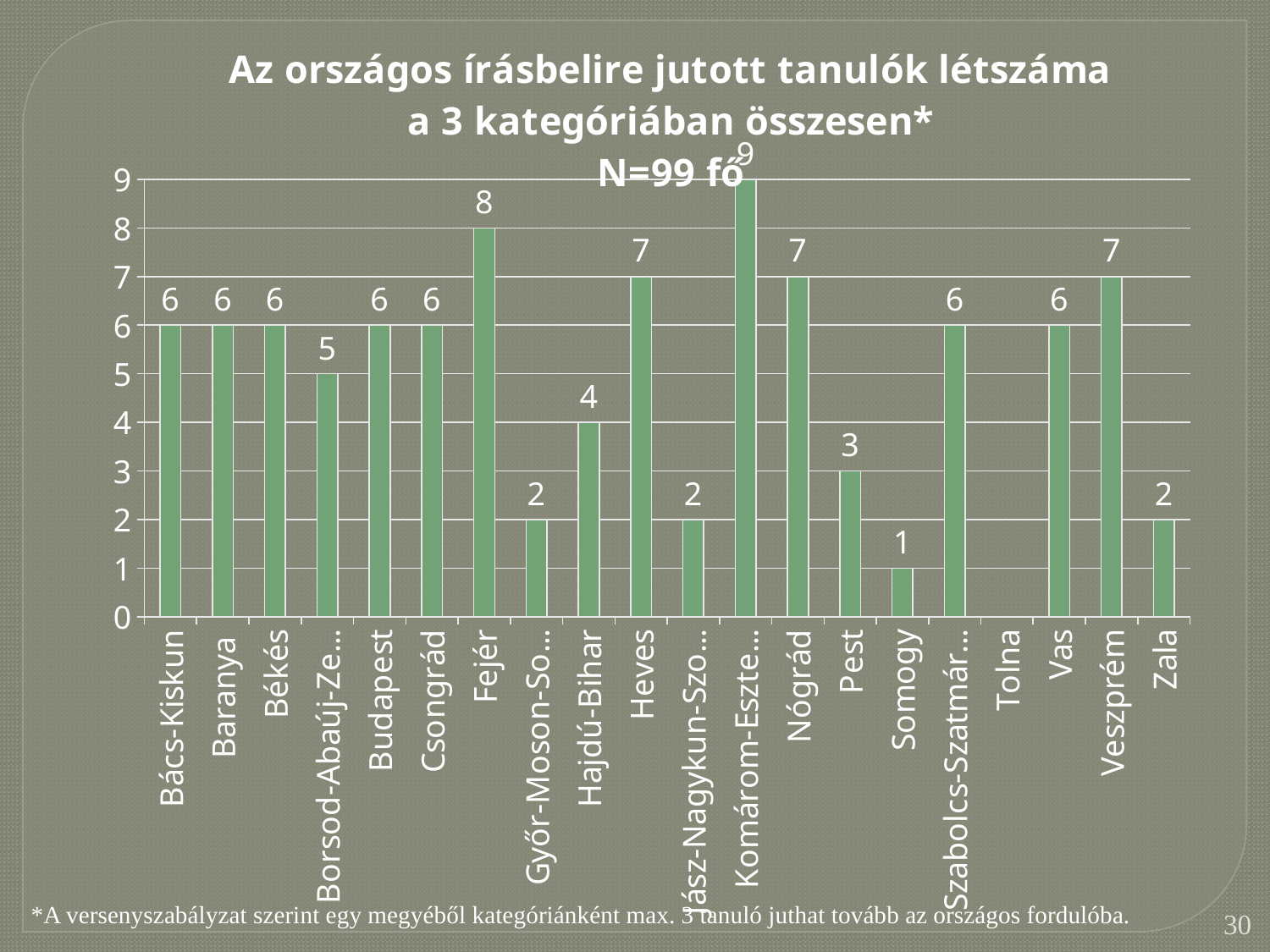
What is the difference between the values for Heves and Pest? 4 What is the difference between the values for Fejér and Zala? 6 Which category has the highest value? Komárom-Eszte… What is the value for Veszprém? 7 What is the value for Somogy? 1 What is the value for Fejér? 8 What is the value for Pest? 3 What is the value for Hajdú-Bihar? 4 How many categories are shown on the x axis? 20 What is the N value stated in the chart title? N=99 fő What kind of chart is shown on the slide? bar chart Which is larger, the value for Nógrád or the value for Budapest? Nógrád